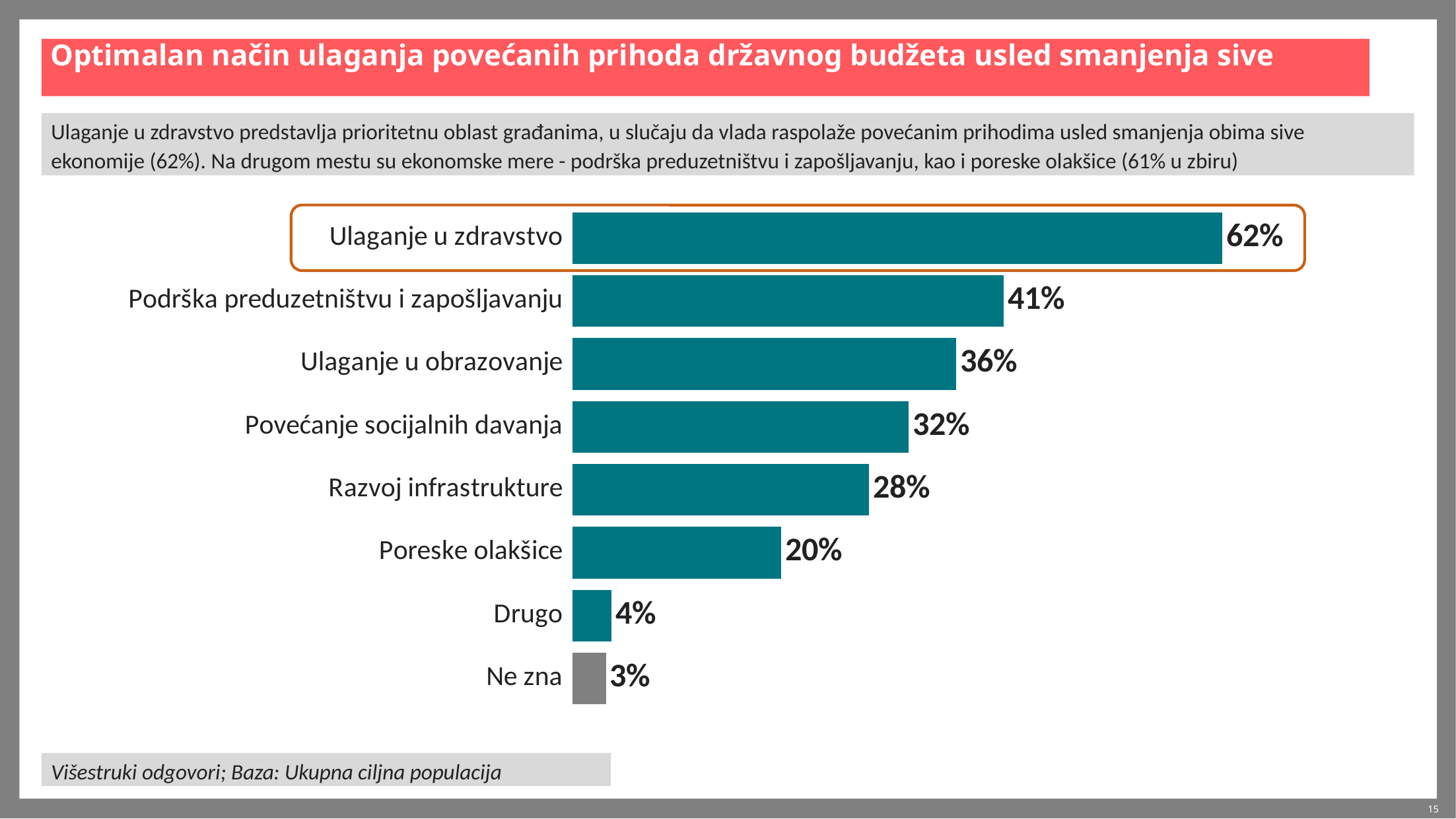
Which category has the highest value? Ulaganje u zdravstvo How many categories are shown in the chart? 8 What kind of chart is shown on the slide? Bar chart Which is larger, the value for Ulaganje u obrazovanje or the value for Razvoj infrastrukture? Ulaganje u obrazovanje What is the value for Ne zna? 3% What is the value for Ulaganje u zdravstvo? 62% What is the value for Podrška preduzetništvu i zapošljavanju? 41% What is the difference between the values for Ulaganje u zdravstvo and Ulaganje u obrazovanje? 26% What is the difference between the values for Povećanje socijalnih davanja and Poreske olakšice? 12% What is the value for Razvoj infrastrukture? 28% Which category's bar is shown in grey rather than teal? Ne zna Which category has the lowest value? Ne zna